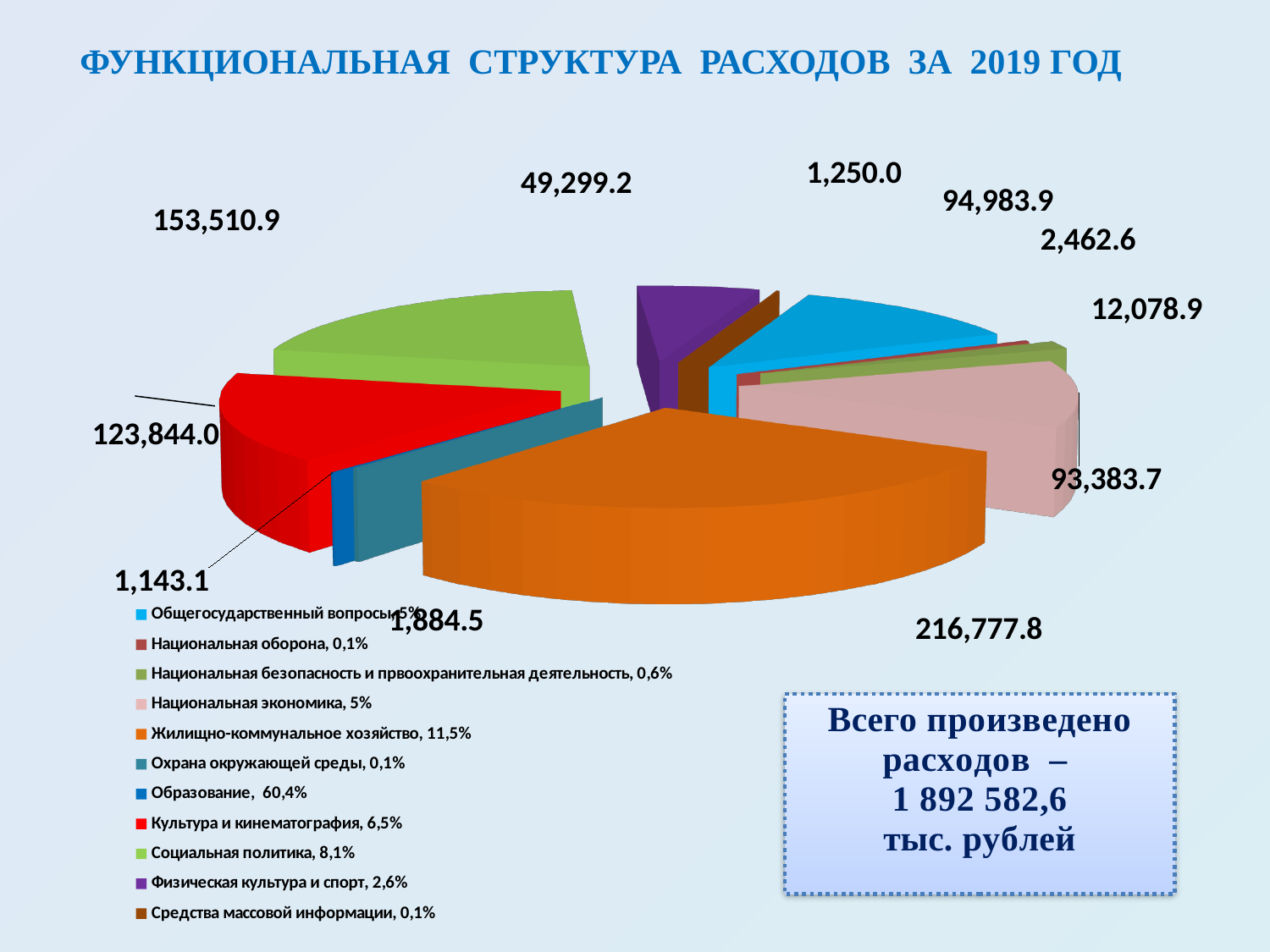
How many categories does the legend of the pie chart list? 11 What is the largest data label printed on the pie chart? 216,777.8 What share does the legend give for Культура и кинематография? 6,5% What is the title of the slide's chart? ФУНКЦИОНАЛЬНАЯ СТРУКТУРА РАСХОДОВ ЗА 2019 ГОД What share does the legend give for Социальная политика? 8,1% According to the text box, what is the total amount of expenditures produced? 1 892 582,6 тыс. рублей What share does the legend give for Жилищно-коммунальное хозяйство? 11,5% What value is labelled on the red slice (Культура и кинематография)? 123,844.0 What value is labelled on the large orange slice (Жилищно-коммунальное хозяйство)? 216,777.8 What kind of chart is shown on the slide? pie chart